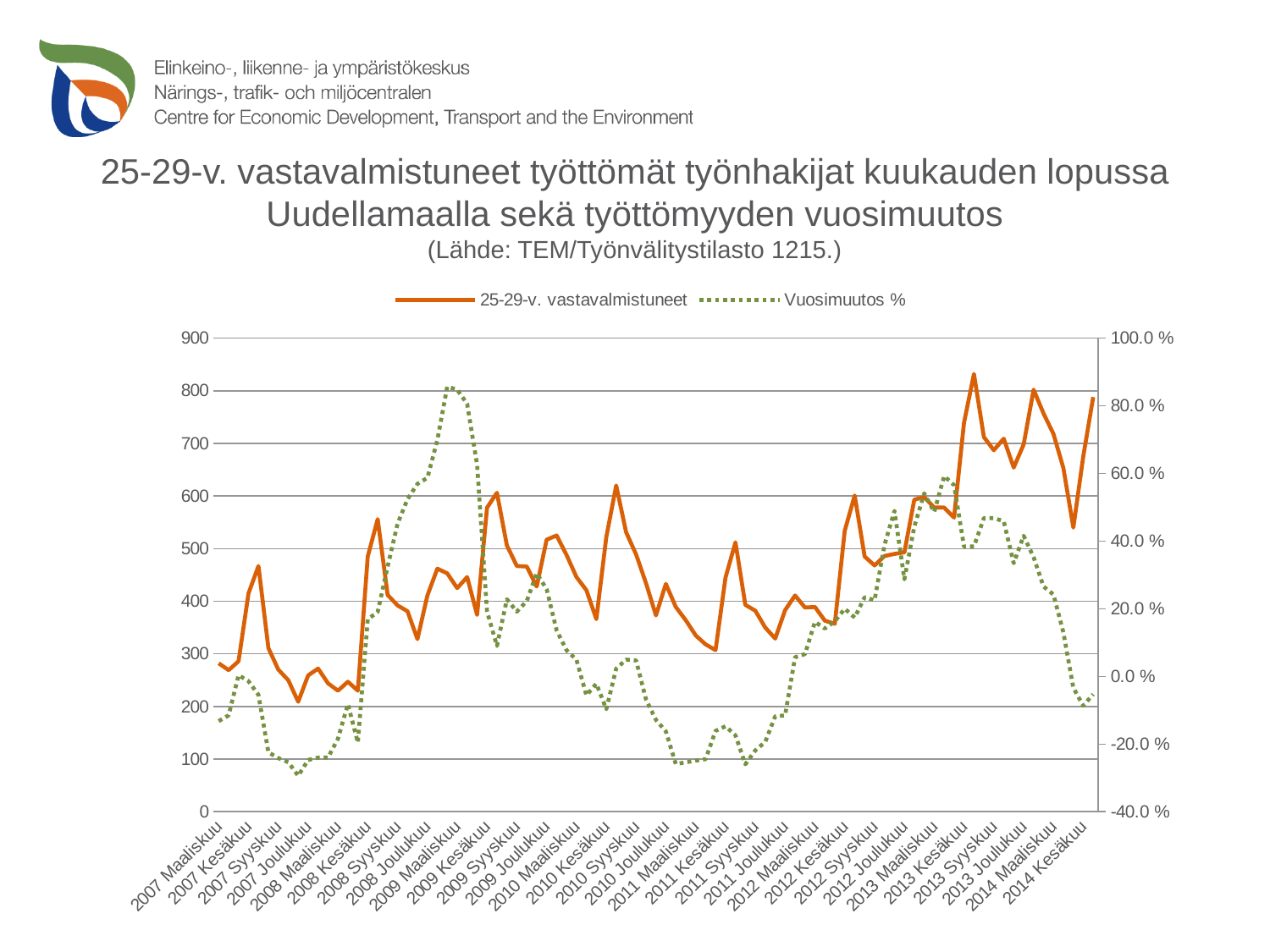
Is the value of 25-29-v. vastavalmistuneet for 2014 Kesäkuu greater or less than 700? less Is the value of 25-29-v. vastavalmistuneet for 2012 Kesäkuu greater or less than 500? greater What kind of chart is shown on the slide? line chart Is the value of 25-29-v. vastavalmistuneet for 2009 Maaliskuu greater or less than 400? greater Overall, does the 25-29-v. vastavalmistuneet line rise or fall from 2007 Maaliskuu to 2014 Kesäkuu? rise What are the two series named in the legend? 25-29-v. vastavalmistuneet and Vuosimuutos % How many series does the legend list? 2 Which series is drawn as a dotted line? Vuosimuutos %